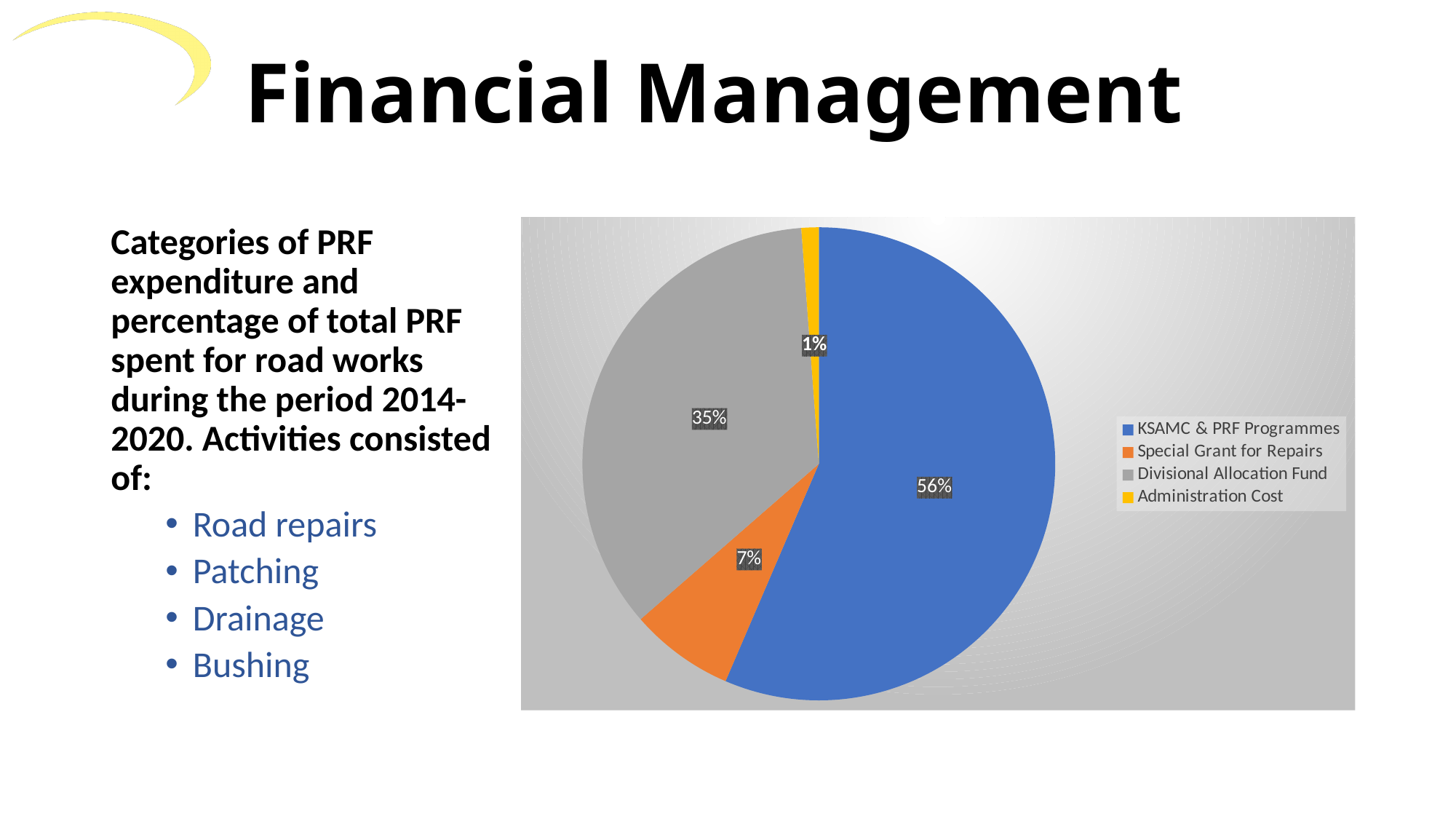
What kind of chart is shown on the slide? Pie chart What is the difference in percentage points between KSAMC & PRF Programmes and Divisional Allocation Fund? 21 What percentage of the pie is Special Grant for Repairs? 7% Which category has the smallest share of the pie? Administration Cost How many categories does the pie chart show? 4 What percentage of the pie is KSAMC & PRF Programmes? 56% What colour is the slice for Divisional Allocation Fund? Grey Which legend entry is shown in orange? Special Grant for Repairs Which category has the largest share of the pie? KSAMC & PRF Programmes What percentage of the pie is Divisional Allocation Fund? 35% What percentage of the pie is Administration Cost? 1% Which is larger: Special Grant for Repairs or Divisional Allocation Fund? Divisional Allocation Fund